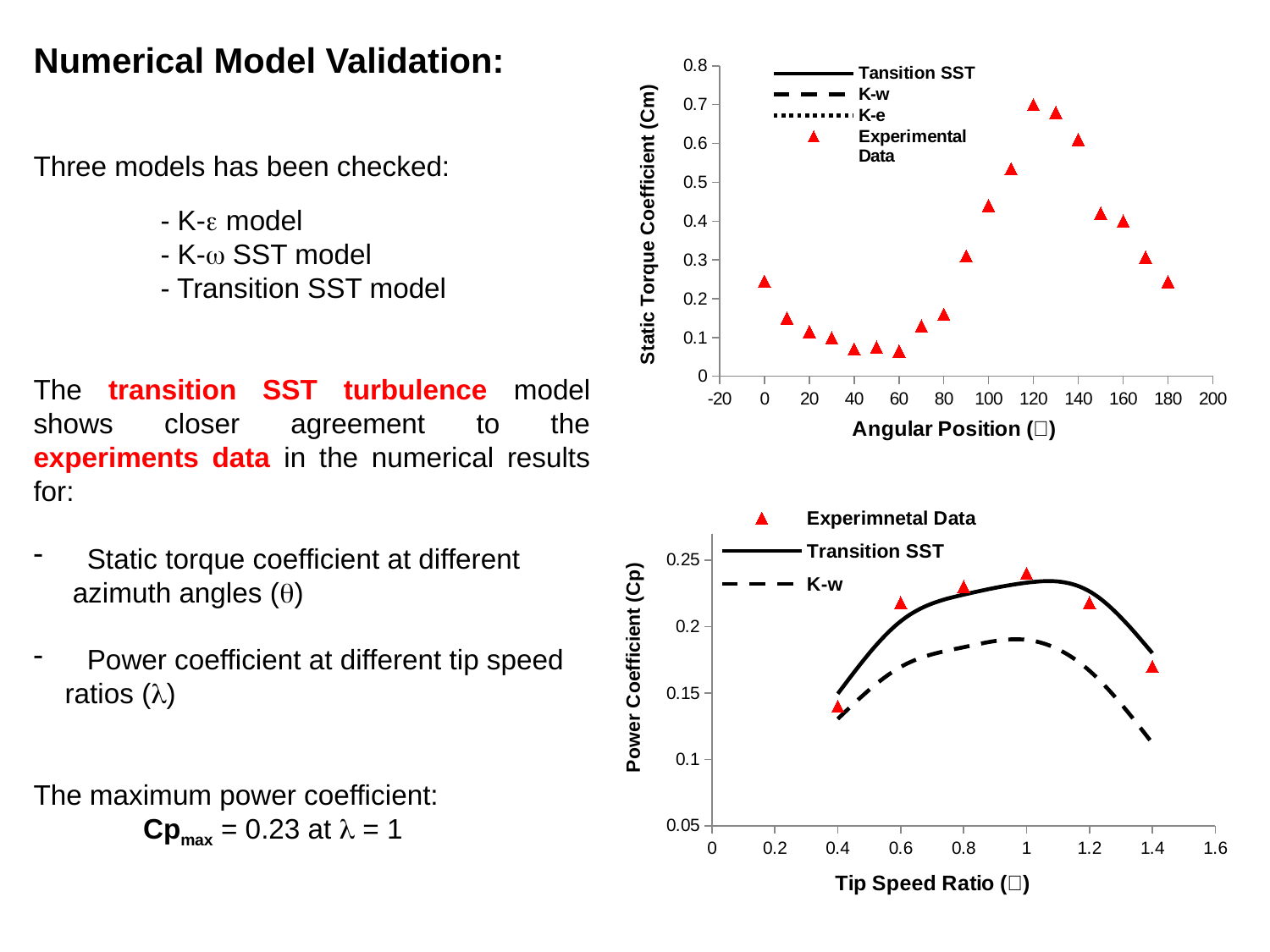
In the bottom chart (Power Coefficient), at which tip speed ratio is the Experimental Data value lowest? 0.4 In the bottom chart (Power Coefficient), which series is higher at a tip speed ratio of 1: Transition SST or K-w? Transition SST In the bottom chart (Power Coefficient), is the Transition SST value at a tip speed ratio of 1 greater or less than 0.2? greater What is the x-axis title of the bottom chart? Tip Speed Ratio In the top chart (Static Torque Coefficient), do the Experimental Data values rise or fall as the angular position goes from 60 to 120? rise In the top chart (Static Torque Coefficient), is the Experimental Data value at an angular position of 0 greater or less than 0.3? less In the top chart (Static Torque Coefficient), is the Experimental Data value at an angular position of 120 greater or less than 0.6? greater In the top chart (Static Torque Coefficient), how many series does the legend list? 4 In the bottom chart (Power Coefficient), how many Experimental Data points are plotted? 6 In the bottom chart (Power Coefficient), how many series does the legend list? 3 In the top chart (Static Torque Coefficient), which is larger: the Experimental Data value at angular position 120 or at angular position 180? 120